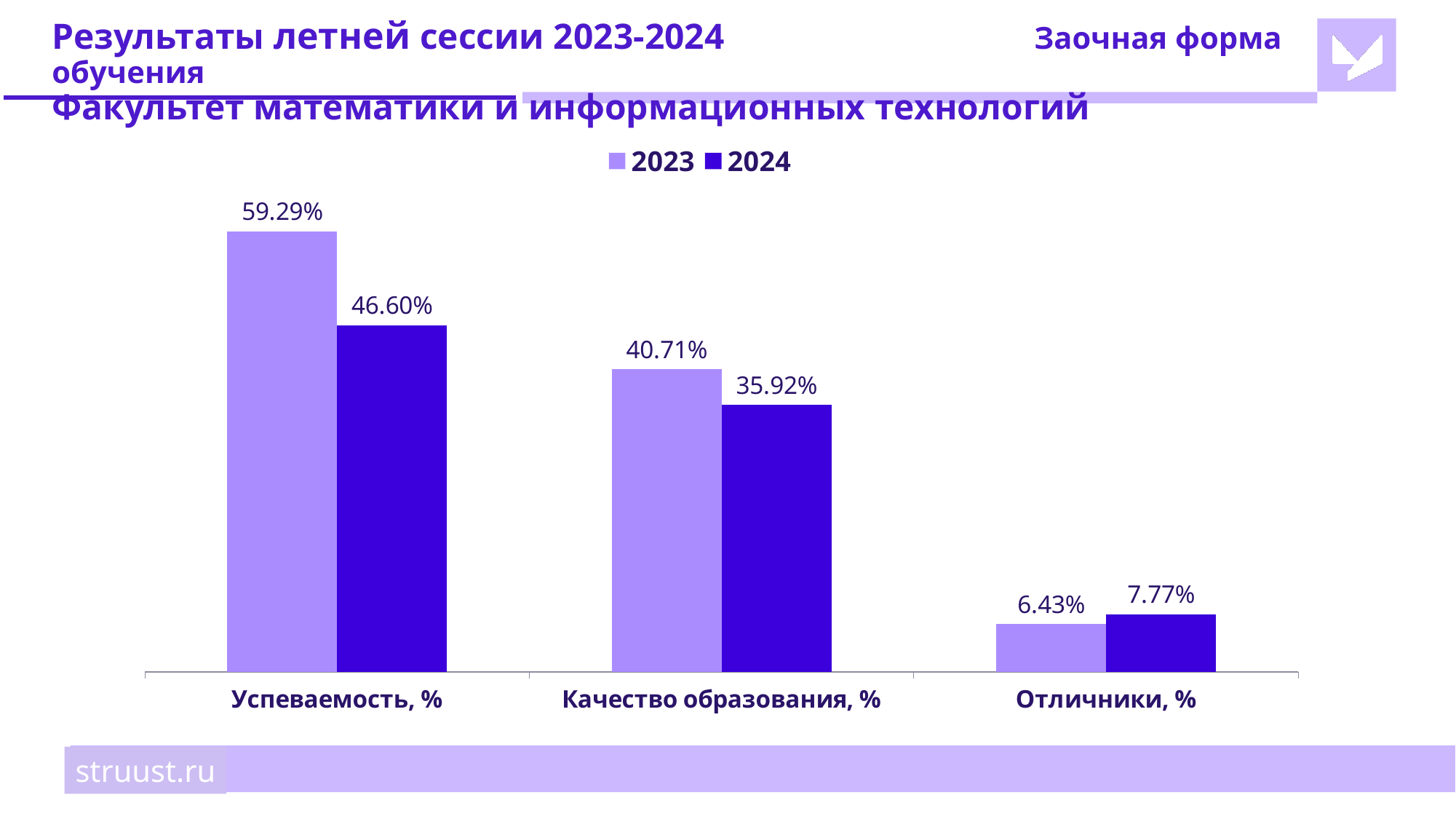
What is the value for Качество образования, % in 2024? 35.92% Which is larger for Качество образования, %: the 2023 value or the 2024 value? 2023 What is the difference between the 2023 and 2024 values for Успеваемость, %? 12.69% Which category has the lowest value for 2024? Отличники, % What is the difference between the 2023 and 2024 values for Отличники, %? 1.34% How many categories are shown on the x axis? 3 How many series does the legend list? 2 What is the value for Успеваемость, % in 2024? 46.60% What is the value for Успеваемость, % in 2023? 59.29% What is the value for Отличники, % in 2023? 6.43% What kind of chart is shown on the slide? Bar chart Which category has the highest value for 2023? Успеваемость, %